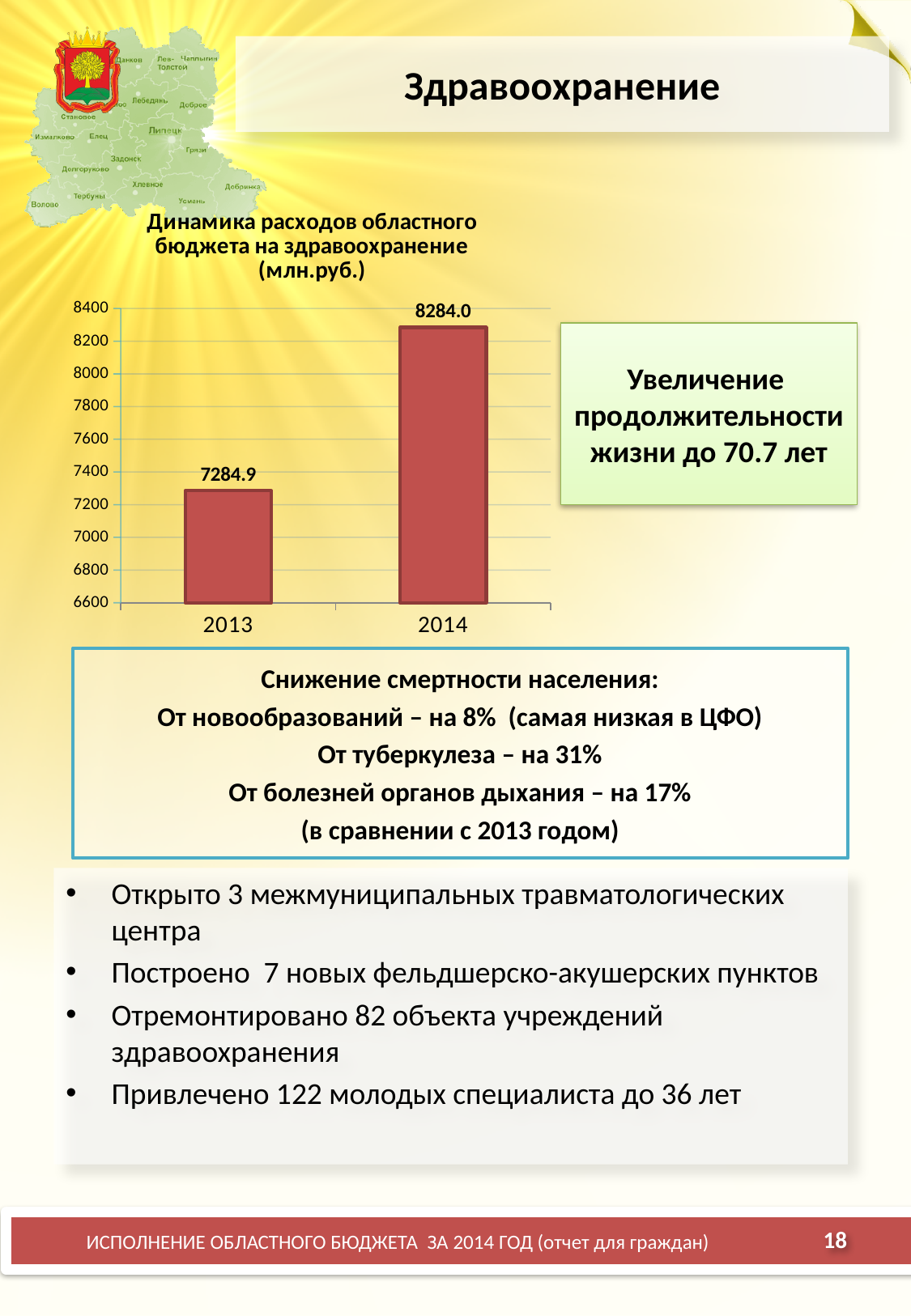
What is the difference between the 2014 and 2013 values in the chart? 999.1 What is the value for 2013 in the chart? 7284.9 What kind of chart is shown on the slide? bar chart Is the value for 2013 greater or less than 7400? less What unit is given in the chart title? млн.руб. How many years are shown on the x axis of the chart? 2 Is the value for 2014 greater or less than 8000? greater Which year has the highest value in the chart? 2014 Do the values rise or fall from 2013 to 2014 in the chart? rise Which year has the lowest value in the chart? 2013 Which is larger in the chart, the value for 2013 or the value for 2014? 2014 What is the value for 2014 in the chart? 8284.0